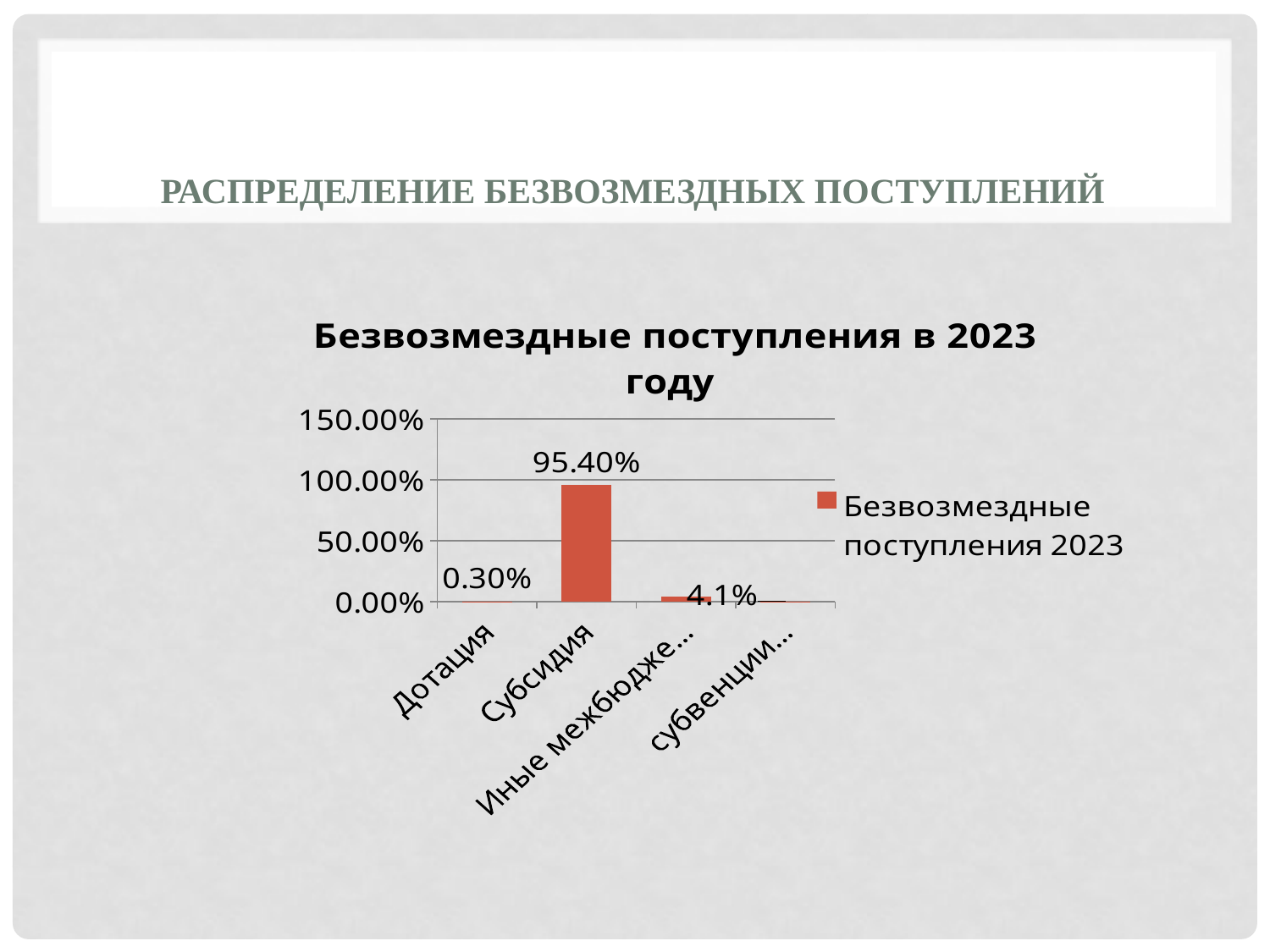
Which category has the highest value in the chart? Субсидия What is the difference between the value for Субсидия and the value for Дотация? 95.10% What kind of chart is shown on the slide? Bar chart What is the value for Субсидия in the chart? 95.40% Is the value for Дотация greater or less than 50.00%? less How many categories are shown on the x axis of the chart? 4 What is the legend entry shown in the chart? Безвозмездные поступления 2023 How many series does the legend list? 1 What is the title of the chart? Безвозмездные поступления в 2023 году Is the value for Субсидия greater or less than 50.00%? greater What is the value for Дотация in the chart? 0.30% Which is larger, the value for Дотация or the value for Субсидия? Субсидия